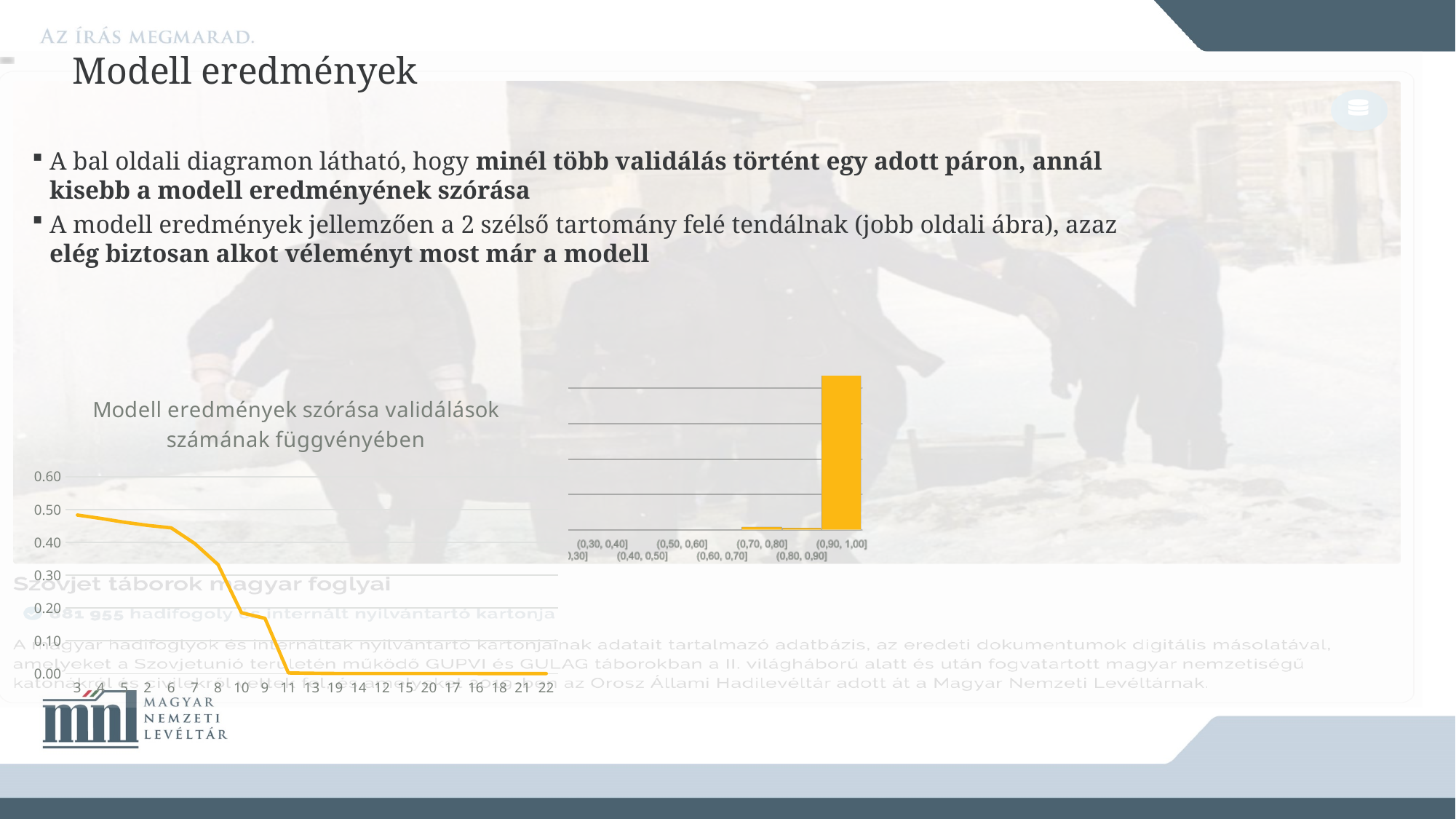
What type of chart is the left chart titled 'Modell eredmények szórása validálások számának függvényében'? line chart In the left chart, is the value for category 22 greater or less than 0.10? less In the left chart, is the value for category 3 greater or less than 0.40? greater In the left chart, which is larger, the value for category 3 or the value for category 13? category 3 In the right chart, which is larger, the bar for (0,90, 1,00] or the bar for (0,70, 0,80]? (0,90, 1,00] In the right chart, which category has the highest bar? (0,90, 1,00] In the left chart, is the value for category 6 greater or less than 0.30? greater What type of chart is the right chart on the slide? bar chart In the left chart, do the values generally rise or fall along the x axis? fall What is the title of the left chart? Modell eredmények szórása validálások számának függvényében What colour are the bars in the right chart? orange/yellow How many categories are shown on the x axis of the left chart? 21